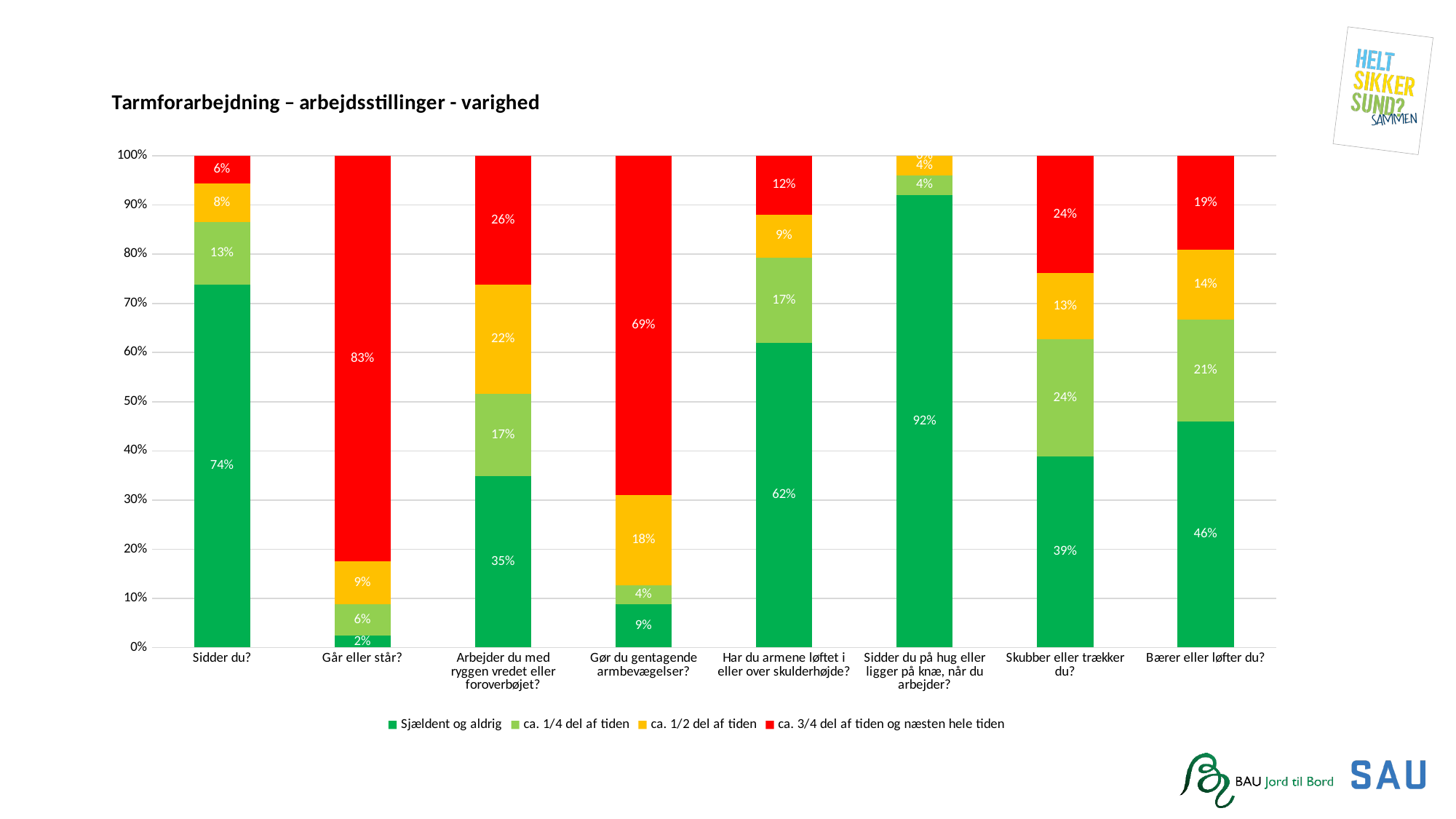
Which is larger: the 'ca. 1/4 del af tiden' value for 'Skubber eller trækker du?' or for 'Bærer eller løfter du?'? Skubber eller trækker du? What is the title of the chart? Tarmforarbejdning – arbejdsstillinger - varighed Which category has the highest value for 'Sjældent og aldrig'? Sidder du på hug eller ligger på knæ, når du arbejder? What kind of chart is shown on the slide? Stacked bar chart What is the value of 'ca. 3/4 del af tiden og næsten hele tiden' for 'Går eller står?'? 83% How many categories are shown on the x axis? 8 What is the difference between the 'ca. 3/4 del af tiden og næsten hele tiden' values for 'Går eller står?' and 'Gør du gentagende armbevægelser?'? 14% What is the value of 'ca. 1/2 del af tiden' for 'Arbejder du med ryggen vredet eller foroverbøjet?'? 22% How many series does the legend list? 4 Which category has the lowest value for 'Sjældent og aldrig'? Går eller står? What is the value of 'ca. 1/2 del af tiden' for 'Gør du gentagende armbevægelser?'? 18% What is the value of 'Sjældent og aldrig' for 'Sidder du?'? 74%